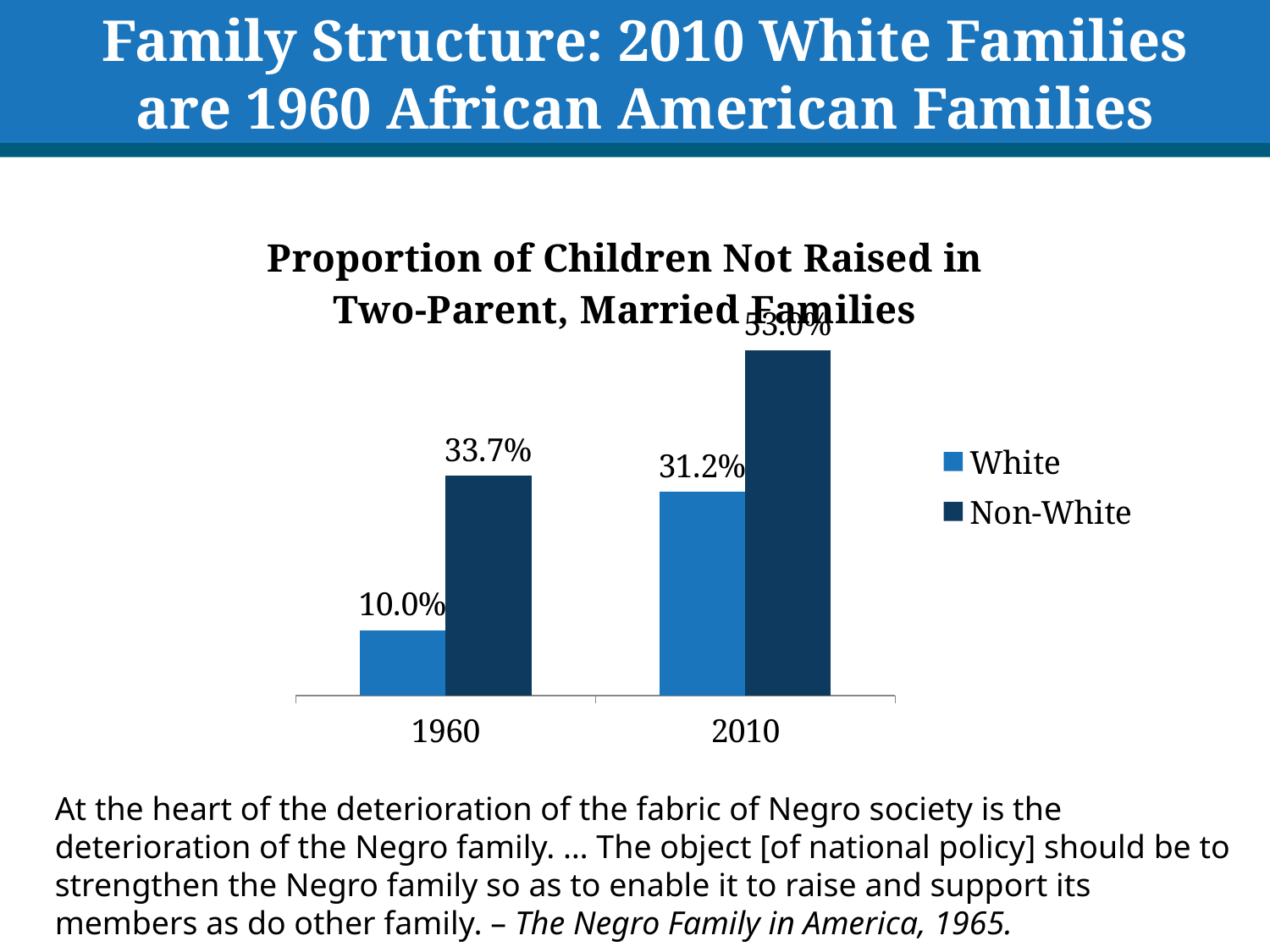
Which is larger: the White value in 2010 or the Non-White value in 1960? Non-White in 1960 What is the value for White in 1960? 10.0% Does the White value rise or fall from 1960 to 2010? Rise What is the difference between the Non-White and White values in 1960? 23.7 percentage points What is the value for Non-White in 2010? 53.0% What is the difference between the White values in 2010 and 1960? 21.2 percentage points Which bar in the chart has the highest value? Non-White in 2010 How many series does the legend list? 2 What is the value for White in 2010? 31.2% What is the value for Non-White in 1960? 33.7% What kind of chart is shown on the slide? Bar chart Which bar in the chart has the lowest value? White in 1960